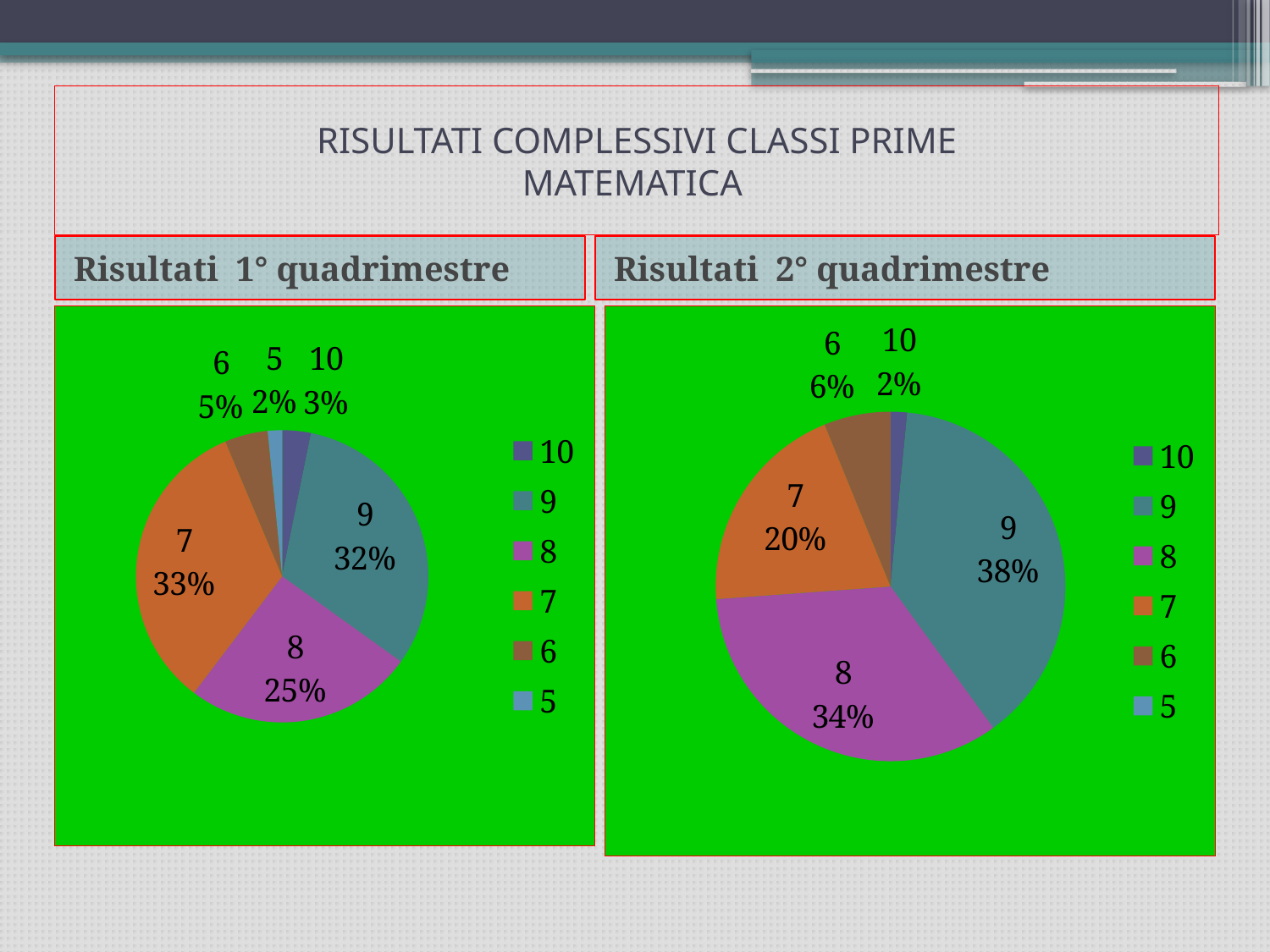
In the 'Risultati 2° quadrimestre' chart, what is the difference between the shares for grade 9 and grade 7? 18% In the 'Risultati 1° quadrimestre' chart, what share of the pie does grade 9 have? 32% In the 'Risultati 1° quadrimestre' chart, which grade has the smallest slice? 5 In the 'Risultati 1° quadrimestre' chart, what is the value for grade 7? 33% What kind of chart is the 'Risultati 1° quadrimestre' chart? Pie chart How many entries does the legend of the 'Risultati 2° quadrimestre' chart list? 6 In the 'Risultati 2° quadrimestre' chart, which is larger, the share for grade 7 or the share for grade 8? 8 In the 'Risultati 2° quadrimestre' chart, which grade has the largest slice? 9 In the 'Risultati 2° quadrimestre' chart, what is the value for grade 6? 6% In the 'Risultati 2° quadrimestre' chart, what share of the pie does grade 8 have? 34% In the 'Risultati 1° quadrimestre' chart, what colour is the slice for grade 8? Purple In the 'Risultati 1° quadrimestre' chart, what is the difference between the shares for grade 7 and grade 8? 8%